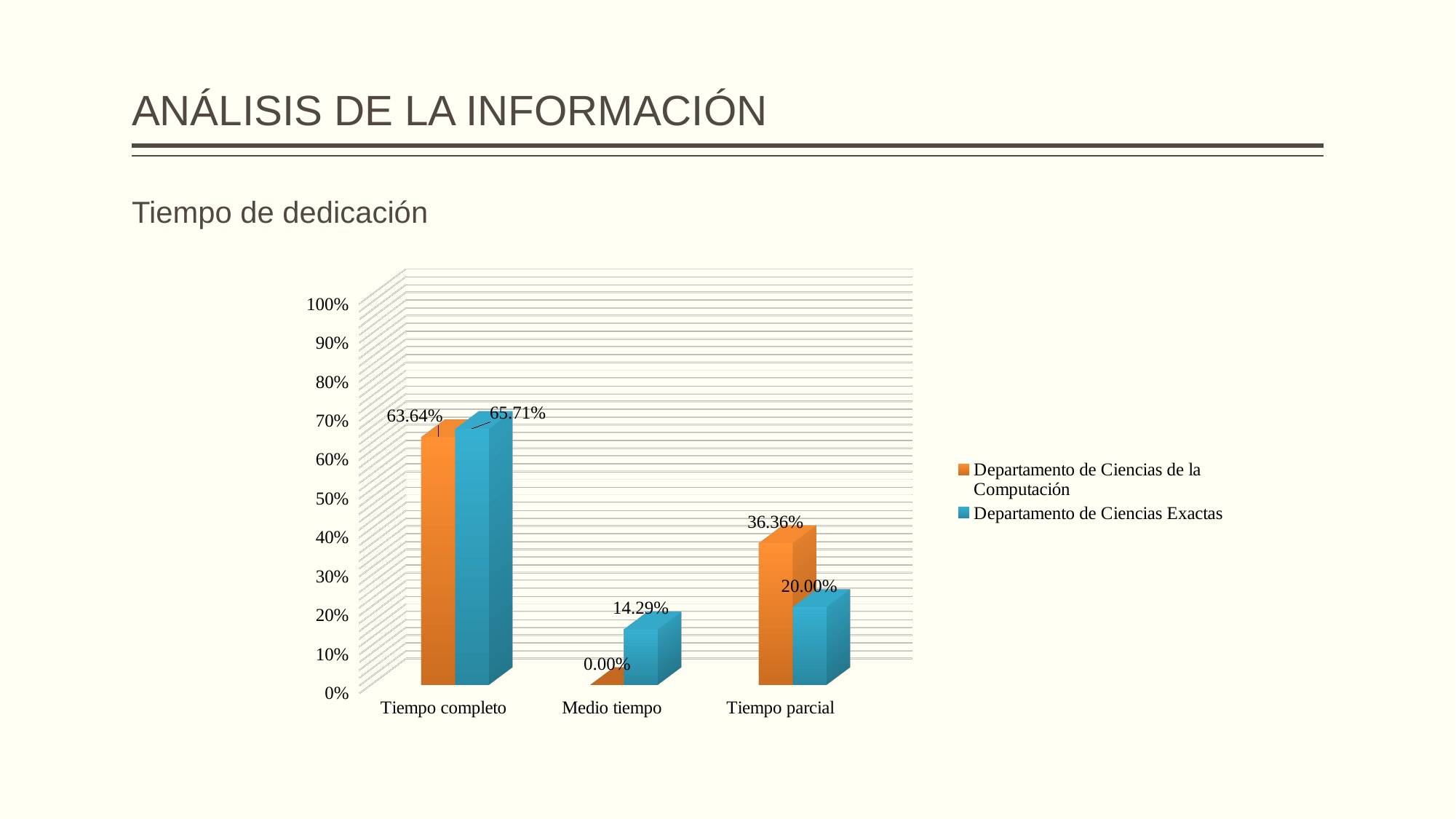
What is the value for Departamento de Ciencias Exactas in the Tiempo completo category? 65.71% Which category has the lowest value for Departamento de Ciencias de la Computación? Medio tiempo In the Tiempo parcial category, which department has the larger value? Departamento de Ciencias de la Computación Which category has the highest value for Departamento de Ciencias Exactas? Tiempo completo What is the value for Departamento de Ciencias de la Computación in the Medio tiempo category? 0.00% How many categories are shown on the x axis? 3 What is the difference between the two departments' values in the Tiempo parcial category? 16.36% What kind of chart is shown on the slide? Bar chart What is the value for Departamento de Ciencias Exactas in the Medio tiempo category? 14.29% How many series does the legend list? 2 What is the value for Departamento de Ciencias de la Computación in the Tiempo parcial category? 36.36% What is the value for Departamento de Ciencias de la Computación in the Tiempo completo category? 63.64%